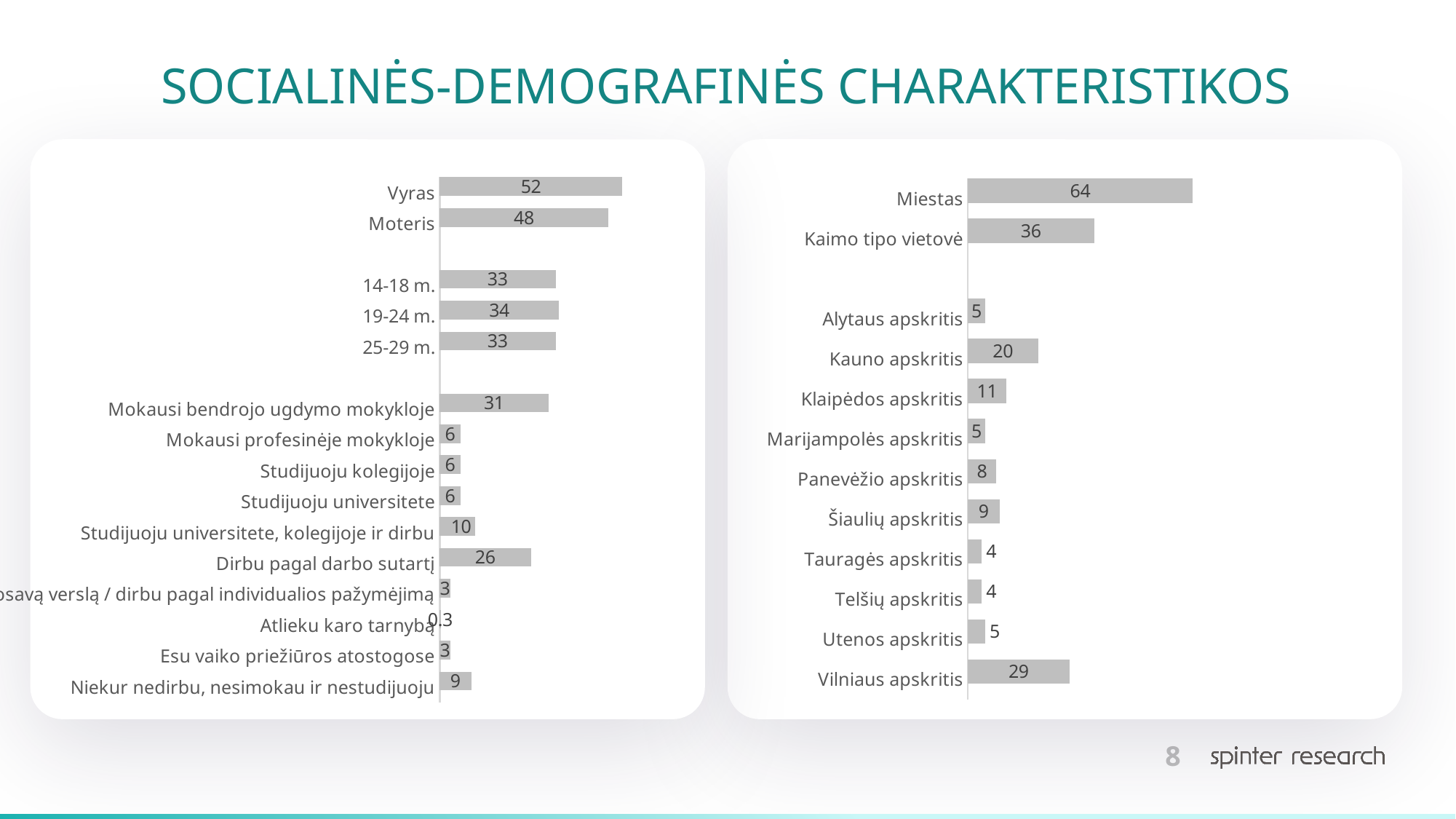
In the left chart, what is the value for Atlieku karo tarnybą? 0.3 In the right chart, which category has the highest value? Miestas In the left chart, which category has the lowest value? Atlieku karo tarnybą In the right chart, which is larger, Klaipėdos apskritis or Panevėžio apskritis? Klaipėdos apskritis What type of chart is the left chart? Bar chart In the left chart, what is the value for Vyras? 52 In the left chart, which is larger, Vyras or Moteris? Vyras In the right chart, which apskritis has the highest value? Vilniaus apskritis In the right chart, what is the value for Kauno apskritis? 20 In the right chart, what is the difference between Miestas and Kaimo tipo vietovė? 28 In the left chart, what is the value for Dirbu pagal darbo sutartį? 26 How many categories are shown in the right chart? 12